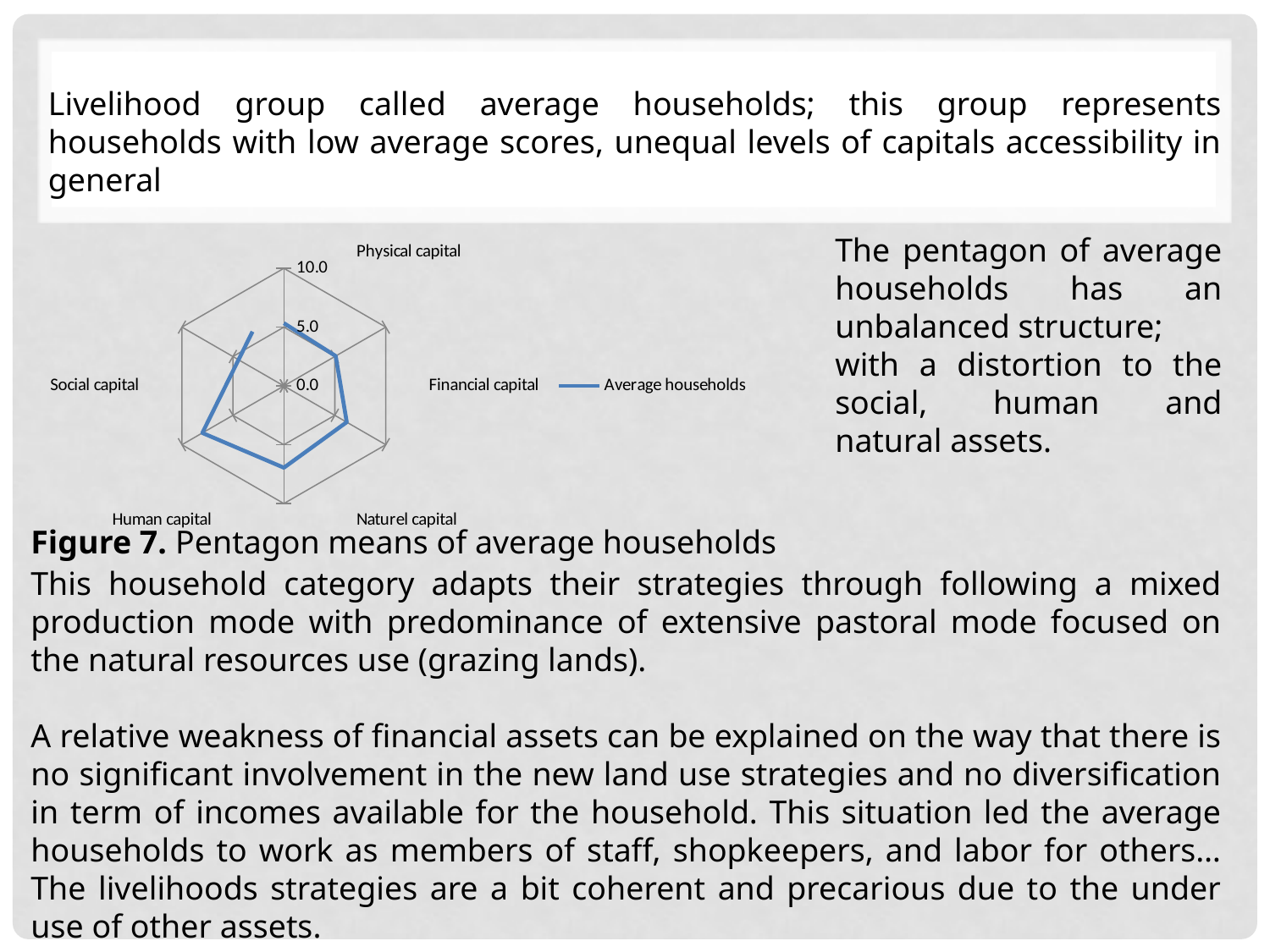
How many series does the legend of the chart list? 1 Does any capital category reach the 10.0 ring on the chart? No What kind of chart is shown in Figure 7? Radar chart What is the name of the series shown in the chart legend? Average households What is the maximum value shown on the chart's axis scale? 10.0 Is the value for Social capital greater or less than 5.0? greater Which is larger, the value for Human capital or the value for Social capital? Social capital Is the value for Human capital greater or less than 5.0? greater